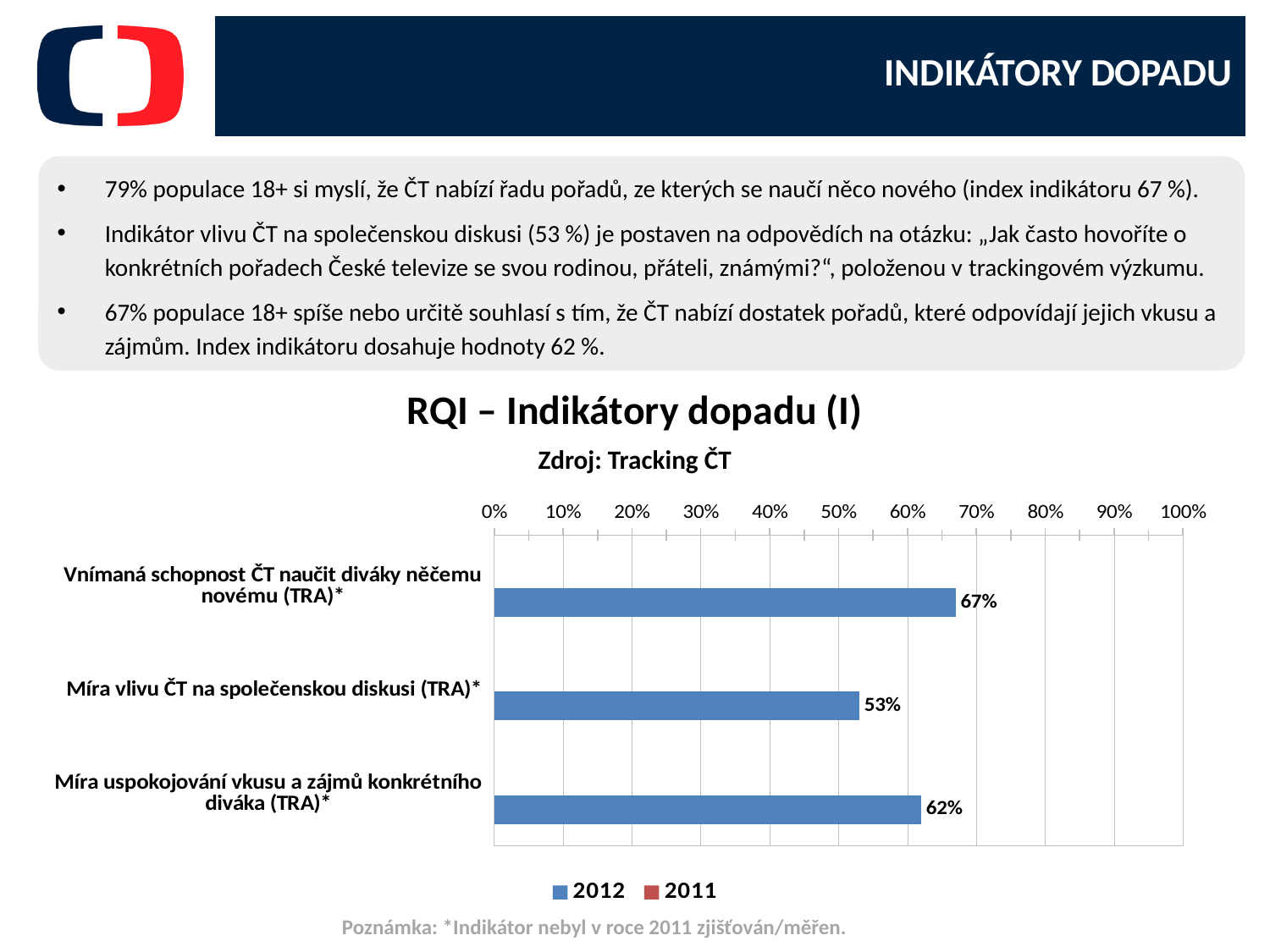
How many categories are shown on the chart? 3 What is the 2012 value for "Míra uspokojování vkusu a zájmů konkrétního diváka (TRA)*"? 62% Which category has the highest 2012 value? Vnímaná schopnost ČT naučit diváky něčemu novému (TRA)* Which is larger: the 2012 value for "Míra uspokojování vkusu a zájmů konkrétního diváka (TRA)*" or for "Míra vlivu ČT na společenskou diskusi (TRA)*"? Míra uspokojování vkusu a zájmů konkrétního diváka (TRA)* How many series does the legend list? 2 Is the 2012 value for "Míra vlivu ČT na společenskou diskusi (TRA)*" greater or less than 60%? less Which category has the lowest 2012 value? Míra vlivu ČT na společenskou diskusi (TRA)* What is the difference between the 2012 values for "Vnímaná schopnost ČT naučit diváky něčemu novému (TRA)*" and "Míra vlivu ČT na společenskou diskusi (TRA)*"? 14% What kind of chart is shown on the slide? bar chart What is the 2012 value for "Vnímaná schopnost ČT naučit diváky něčemu novému (TRA)*"? 67% What is the 2012 value for "Míra vlivu ČT na společenskou diskusi (TRA)*"? 53% What is the difference between the 2012 values for "Míra uspokojování vkusu a zájmů konkrétního diváka (TRA)*" and "Míra vlivu ČT na společenskou diskusi (TRA)*"? 9%